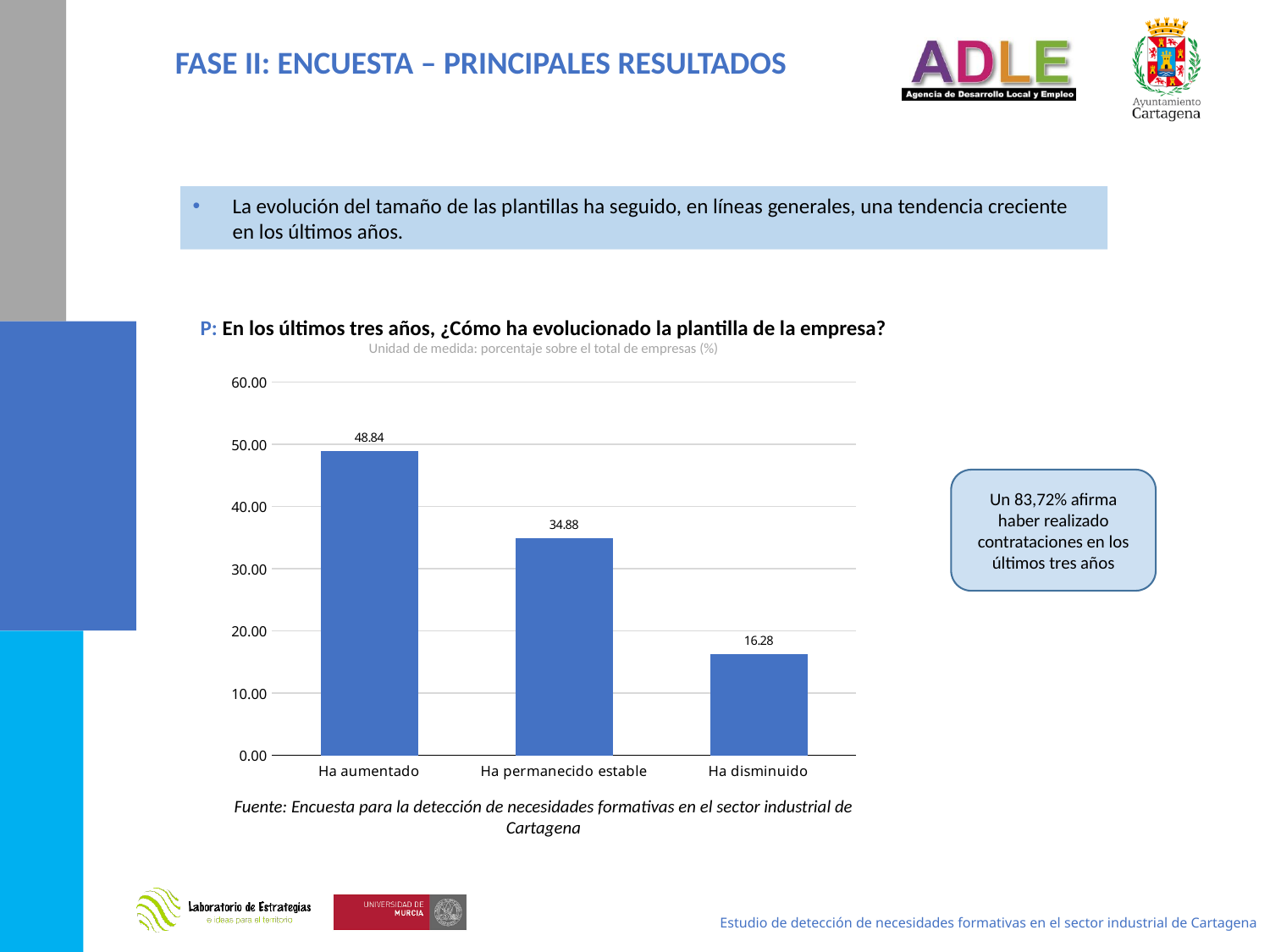
What is the value for "Ha aumentado"? 48.84 What is the difference between the values for "Ha aumentado" and "Ha permanecido estable"? 13.96 Which category has the lowest value? Ha disminuido What kind of chart is shown on the slide? bar chart What is the value for "Ha permanecido estable"? 34.88 Is the value for "Ha aumentado" greater or less than 50.00? less How many categories are shown in the chart? 3 Which is larger, the value for "Ha permanecido estable" or the value for "Ha disminuido"? Ha permanecido estable What is the value for "Ha disminuido"? 16.28 Do the values rise or fall from left to right across the categories? fall Which category has the highest value? Ha aumentado What is the difference between the values for "Ha permanecido estable" and "Ha disminuido"? 18.60